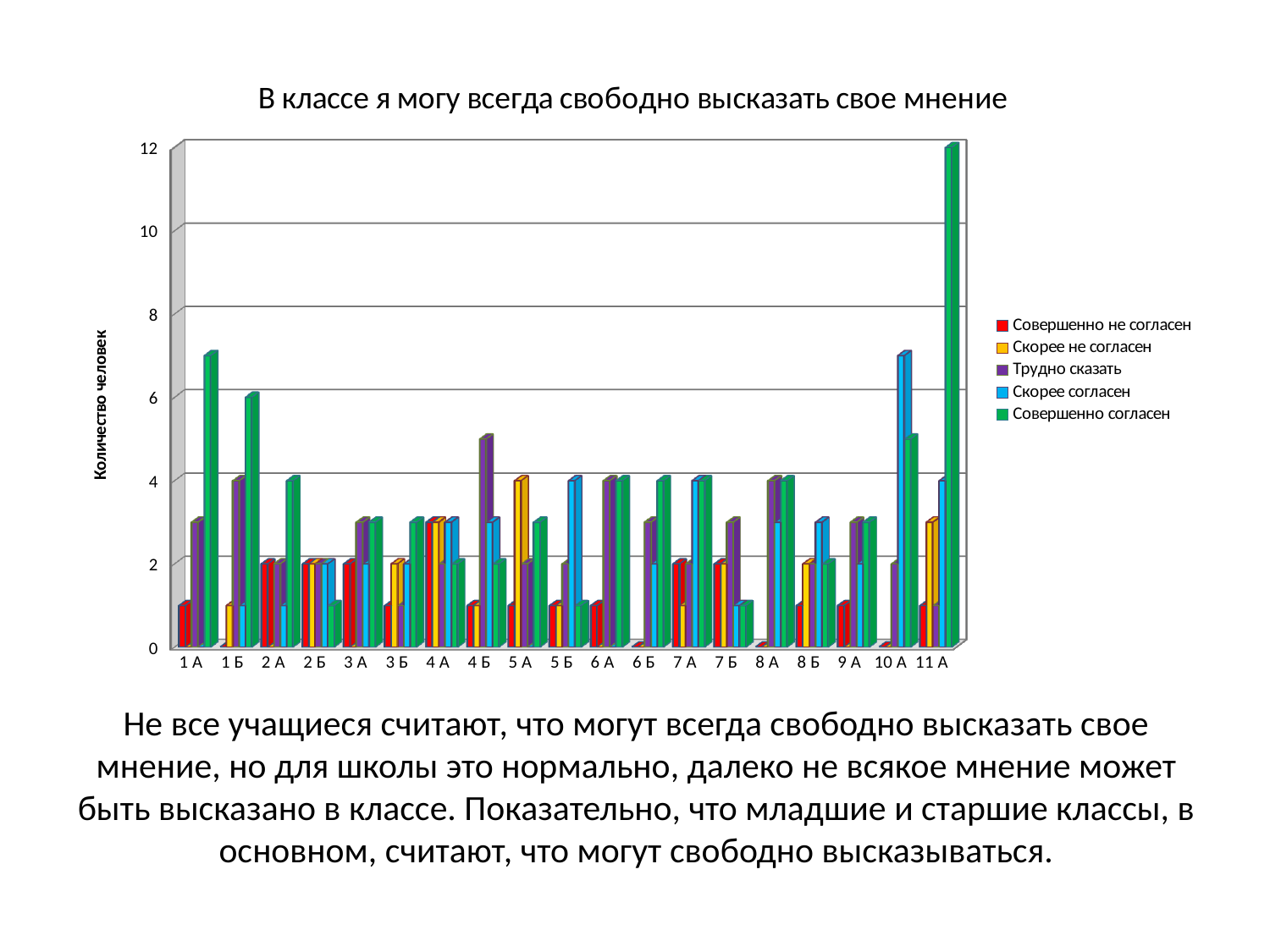
Is the value for 'Трудно сказать' in class 4 Б greater or less than 4? greater What is the title of the chart? В классе я могу всегда свободно высказать свое мнение How many class categories are shown on the x axis? 19 Is the value for 'Совершенно не согласен' in class 3 Б greater or less than 2? less What is the value for 'Совершенно согласен' in class 11 А? 12 Is the value for 'Совершенно согласен' in class 1 А greater or less than 6? greater How many series does the legend list? 5 What is the label of the vertical axis? Количество человек Which is larger: 'Совершенно согласен' in class 11 А or 'Скорее согласен' in class 10 А? Совершенно согласен in class 11 А Which class has the highest bar for 'Совершенно согласен'? 11 А What kind of chart is shown on the slide? bar chart